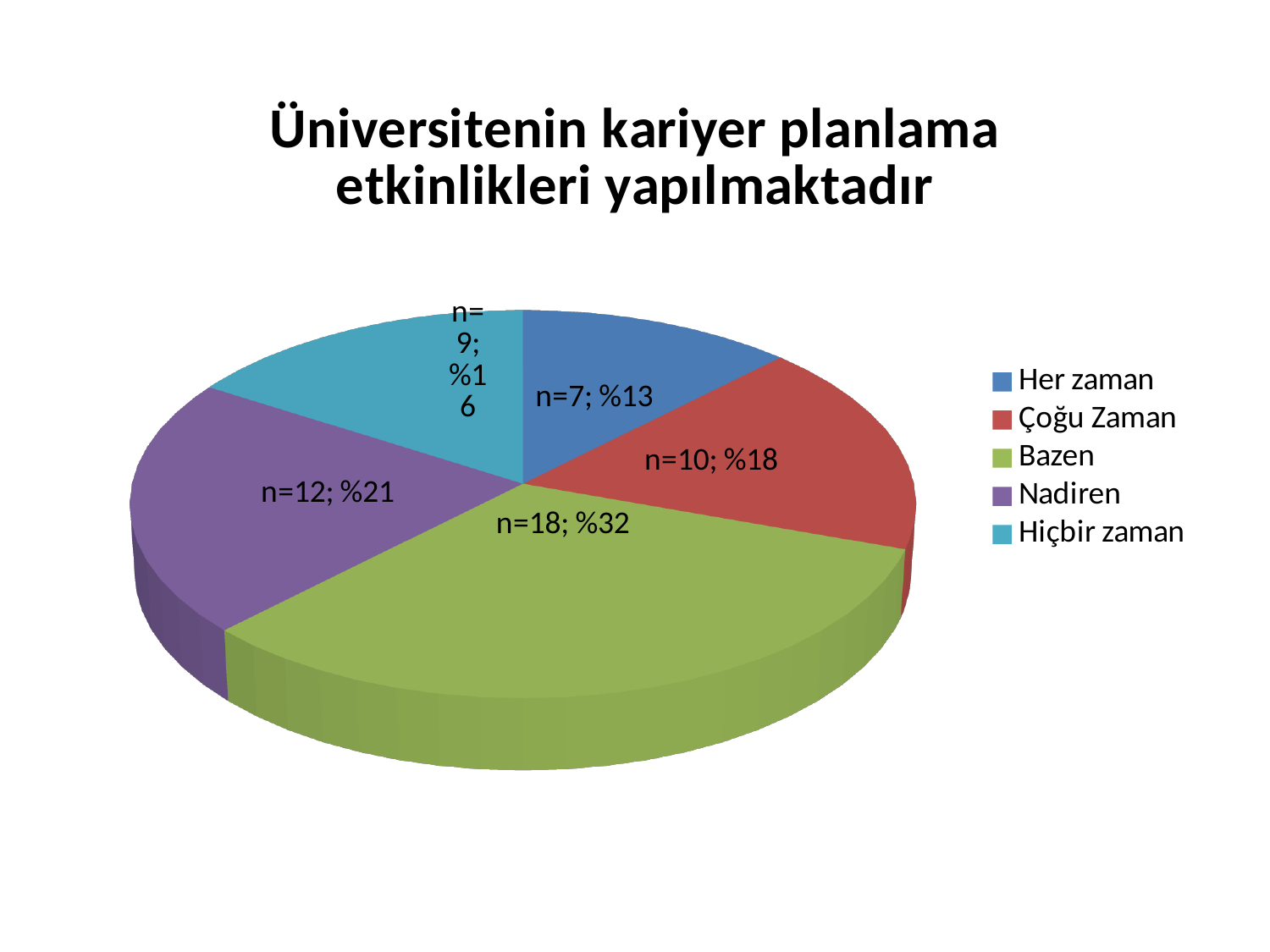
What percentage share does the 'Nadiren' slice have? %21 Which colour represents 'Çoğu Zaman' in the legend? Red What is the n value for the 'Bazen' slice? n=18 Which category has the smallest slice? Her zaman Which category has the largest slice? Bazen What is the n value for the 'Her zaman' slice? n=7 How many categories does the legend list? 5 What is the title of the chart? Üniversitenin kariyer planlama etkinlikleri yapılmaktadır What kind of chart is shown on the slide? Pie chart Which is larger, the 'Nadiren' slice or the 'Hiçbir zaman' slice? Nadiren What is the difference in n between 'Bazen' and 'Çoğu Zaman'? 8 What percentage share does the 'Hiçbir zaman' slice have? %16